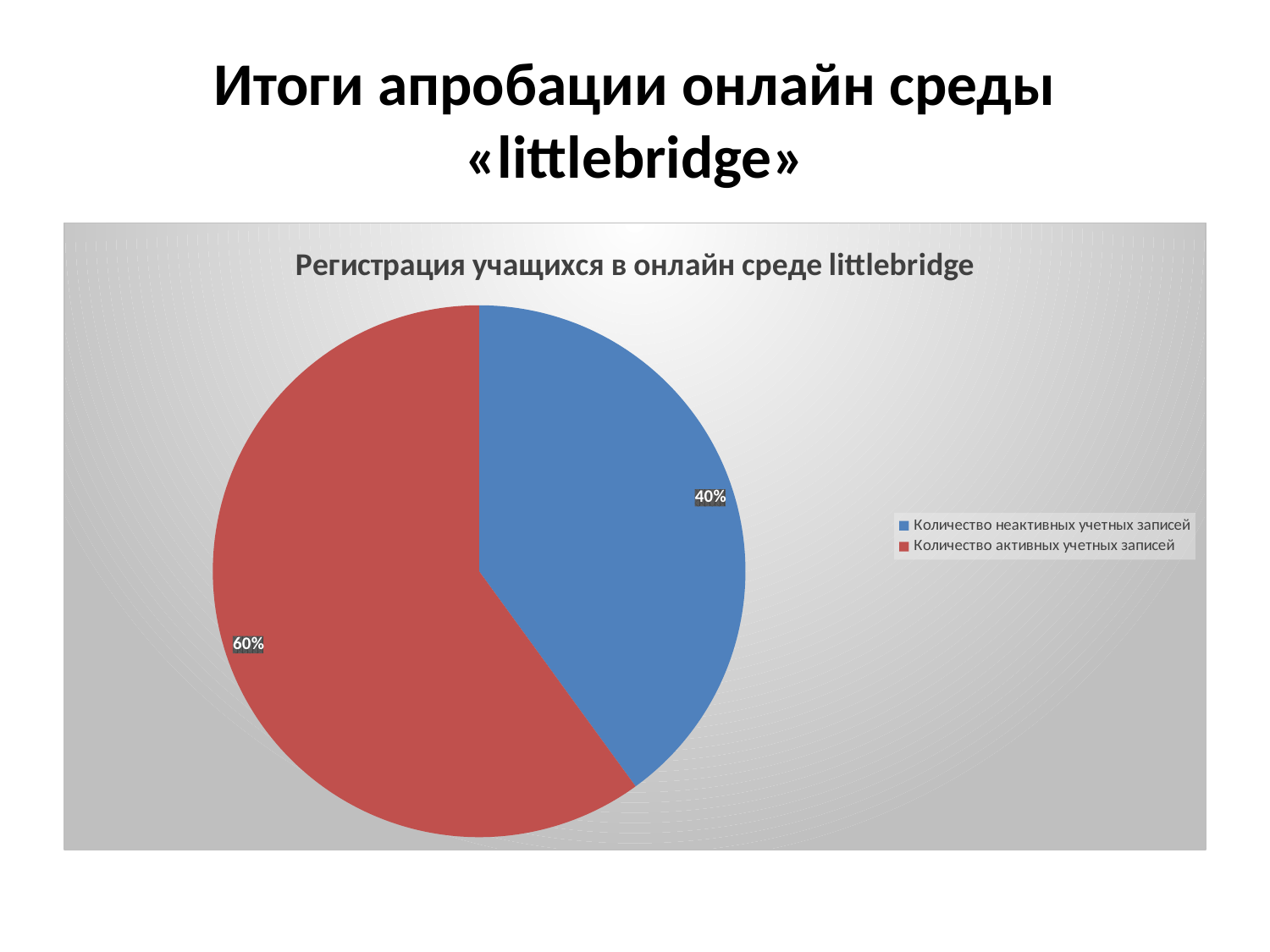
What share of the pie is labelled "Количество активных учетных записей"? 60% What colour is the slice for "Количество неактивных учетных записей"? blue What is the title of the chart? Регистрация учащихся в онлайн среде littlebridge What kind of chart is shown on the slide? pie chart How many slices does the pie chart have? 2 What is the difference in percentage points between the active and inactive account slices? 20% Which category has the largest slice of the pie? Количество активных учетных записей Which is larger: the slice for active accounts or the slice for inactive accounts? Количество активных учетных записей What share of the pie is labelled "Количество неактивных учетных записей"? 40% Which category has the smallest slice of the pie? Количество неактивных учетных записей How many entries does the legend list? 2